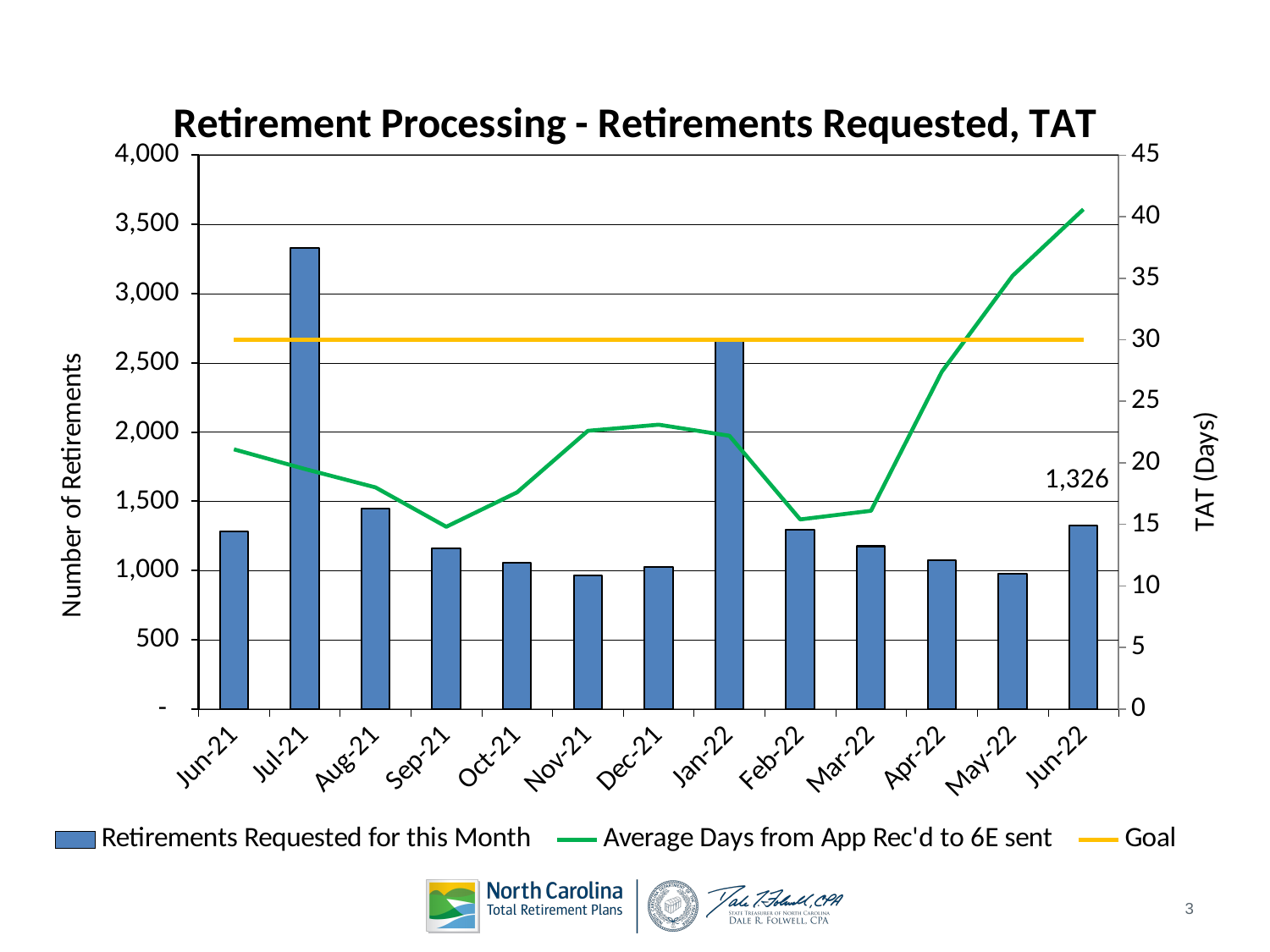
What is the number of retirements requested for Jun-22? 1,326 How many series does the legend list? 3 Which is larger, the number of retirements requested in Jul-21 or in Jan-22? Jul-21 Which month has the highest average days from App Rec'd to 6E sent? Jun-22 Is the number of retirements requested in Jul-21 greater or less than 3,000? greater Is the average days from App Rec'd to 6E sent in Jun-22 greater or less than 35? greater Is the average days from App Rec'd to 6E sent in Sep-21 greater or less than 20? less What kind of chart is this? Combination bar and line chart What value does the Goal line sit at on the TAT (Days) axis? 30 Which month has the highest number of retirements requested? Jul-21 How many months are shown on the x axis? 13